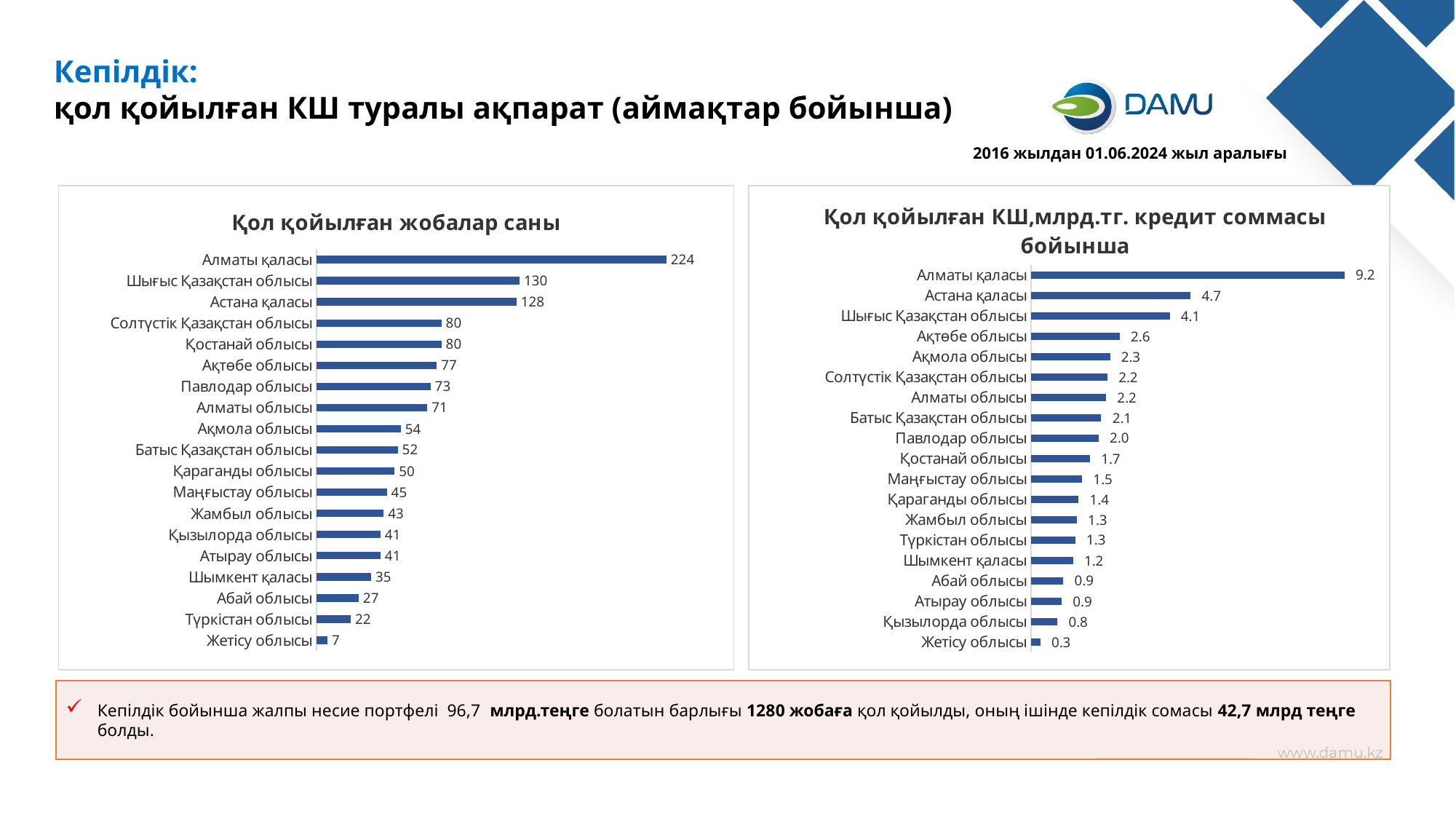
In the chart 'Қол қойылған КШ,млрд.тг. кредит соммасы бойынша', what is the value for Ақтөбе облысы? 2.6 In the chart 'Қол қойылған КШ,млрд.тг. кредит соммасы бойынша', what is the value for Жетісу облысы? 0.3 In the chart 'Қол қойылған КШ,млрд.тг. кредит соммасы бойынша', which is larger: Астана қаласы or Шығыс Қазақстан облысы? Астана қаласы In the chart 'Қол қойылған жобалар саны', which category has the highest value? Алматы қаласы In the chart 'Қол қойылған жобалар саны', what is the difference between the values for Алматы қаласы and Шығыс Қазақстан облысы? 94 In the chart 'Қол қойылған жобалар саны', what is the value for Павлодар облысы? 73 In the chart 'Қол қойылған КШ,млрд.тг. кредит соммасы бойынша', which category has the highest value? Алматы қаласы In the chart 'Қол қойылған жобалар саны', which category has the lowest value? Жетісу облысы In the chart 'Қол қойылған КШ,млрд.тг. кредит соммасы бойынша', what is the difference between the values for Алматы қаласы and Астана қаласы? 4.5 In the chart 'Қол қойылған жобалар саны', what is the value for Астана қаласы? 128 What kind of chart is 'Қол қойылған КШ,млрд.тг. кредит соммасы бойынша'? Bar chart In the chart 'Қол қойылған жобалар саны', how many categories are shown? 19